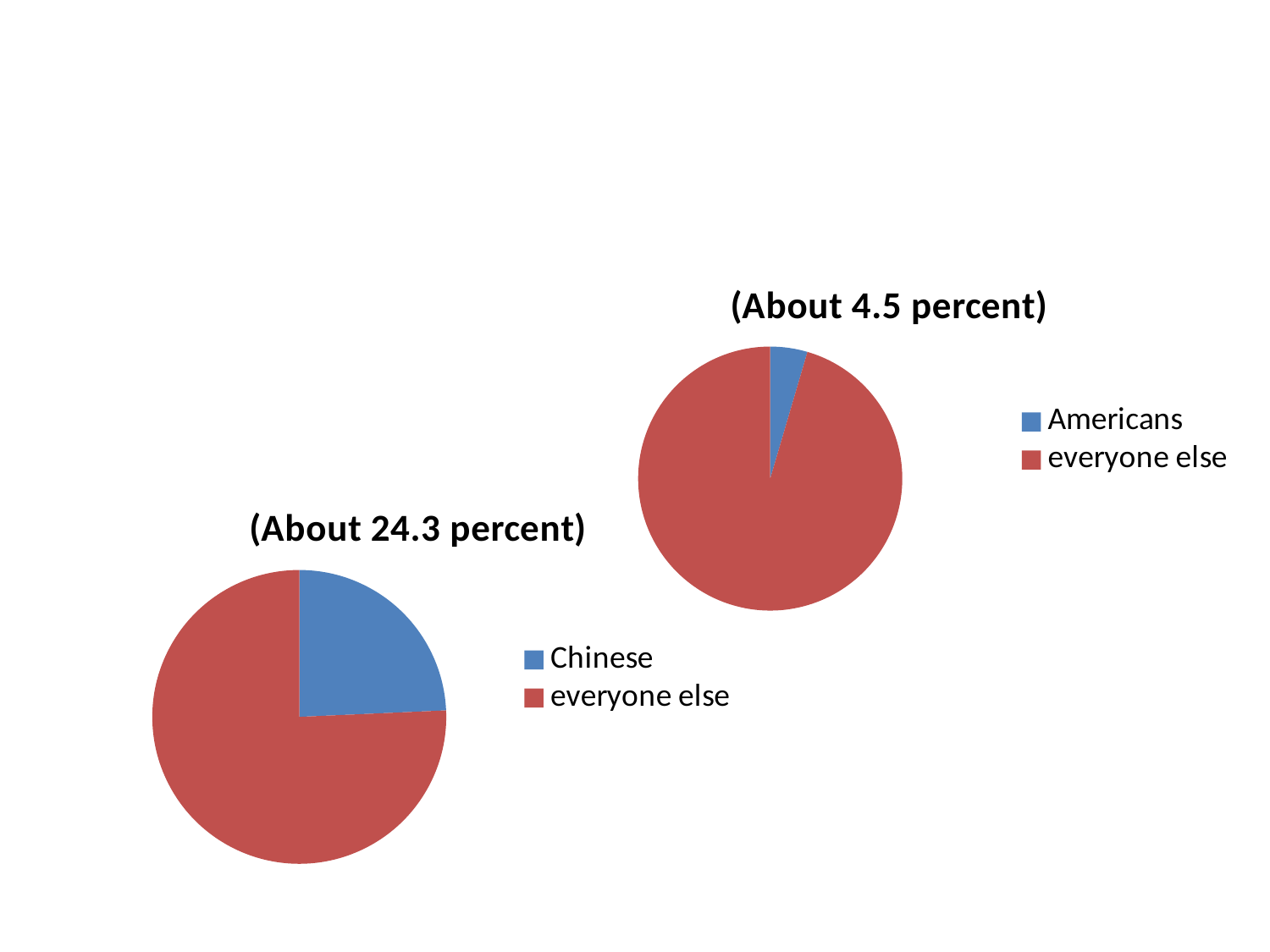
In the chart titled "(About 4.5 percent)", which slice is the smallest? Americans In the chart titled "(About 4.5 percent)", how many entries does the legend list? 2 What kind of chart is the chart titled "(About 4.5 percent)"? pie chart In the chart titled "(About 4.5 percent)", which slice is larger, Americans or everyone else? everyone else What kind of chart is the chart titled "(About 24.3 percent)"? pie chart What colour is the Americans slice in the chart titled "(About 4.5 percent)"? blue In the chart titled "(About 24.3 percent)", which slice is larger, Chinese or everyone else? everyone else In the chart titled "(About 24.3 percent)", how many slices does the pie have? 2 What are the two legend entries of the chart in the lower left of the slide? Chinese, everyone else In the chart titled "(About 24.3 percent)", which slice is the largest? everyone else